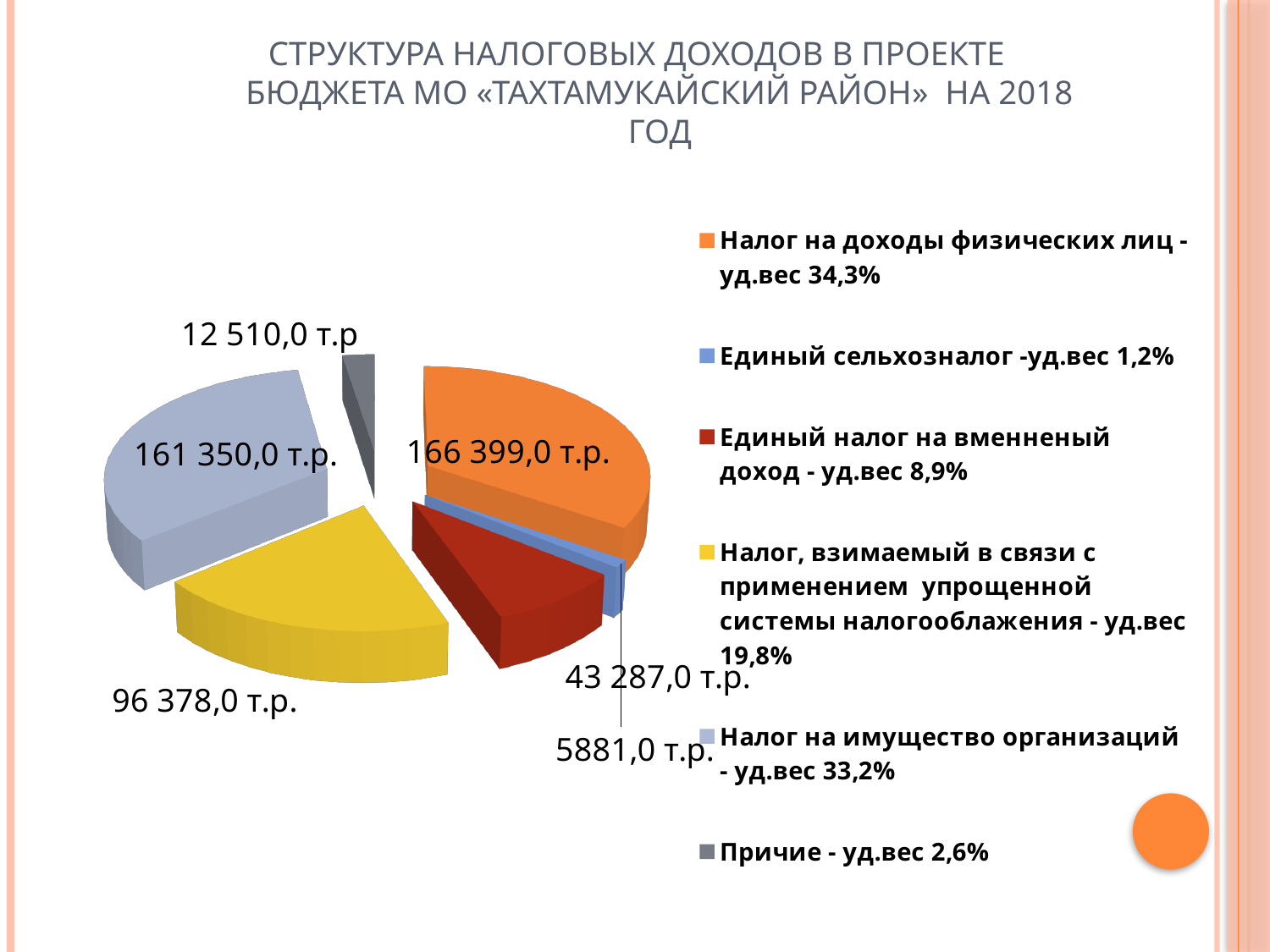
Which category has the largest slice of the pie? Налог на доходы физических лиц How many slices does the pie chart have? 6 What value is shown for the slice 'Налог на доходы физических лиц'? 166 399,0 т.р. According to the legend, what share of the pie does 'Налог, взимаемый в связи с применением упрощенной системы налогооблажения' have? 19,8% What value is shown for the slice 'Налог на имущество организаций'? 161 350,0 т.р. According to the legend, what share of the pie does 'Налог на имущество организаций' have? 33,2% What value is shown for the slice 'Причие'? 12 510,0 т.р What value is shown for the slice 'Единый налог на вменненый доход'? 43 287,0 т.р. Which category has the smallest slice of the pie? Единый сельхозналог What kind of chart is shown on the slide? Pie chart What value is shown for the slice 'Налог, взимаемый в связи с применением упрощенной системы налогооблажения'? 96 378,0 т.р. What value is shown for the slice 'Единый сельхозналог'? 5881,0 т.р.